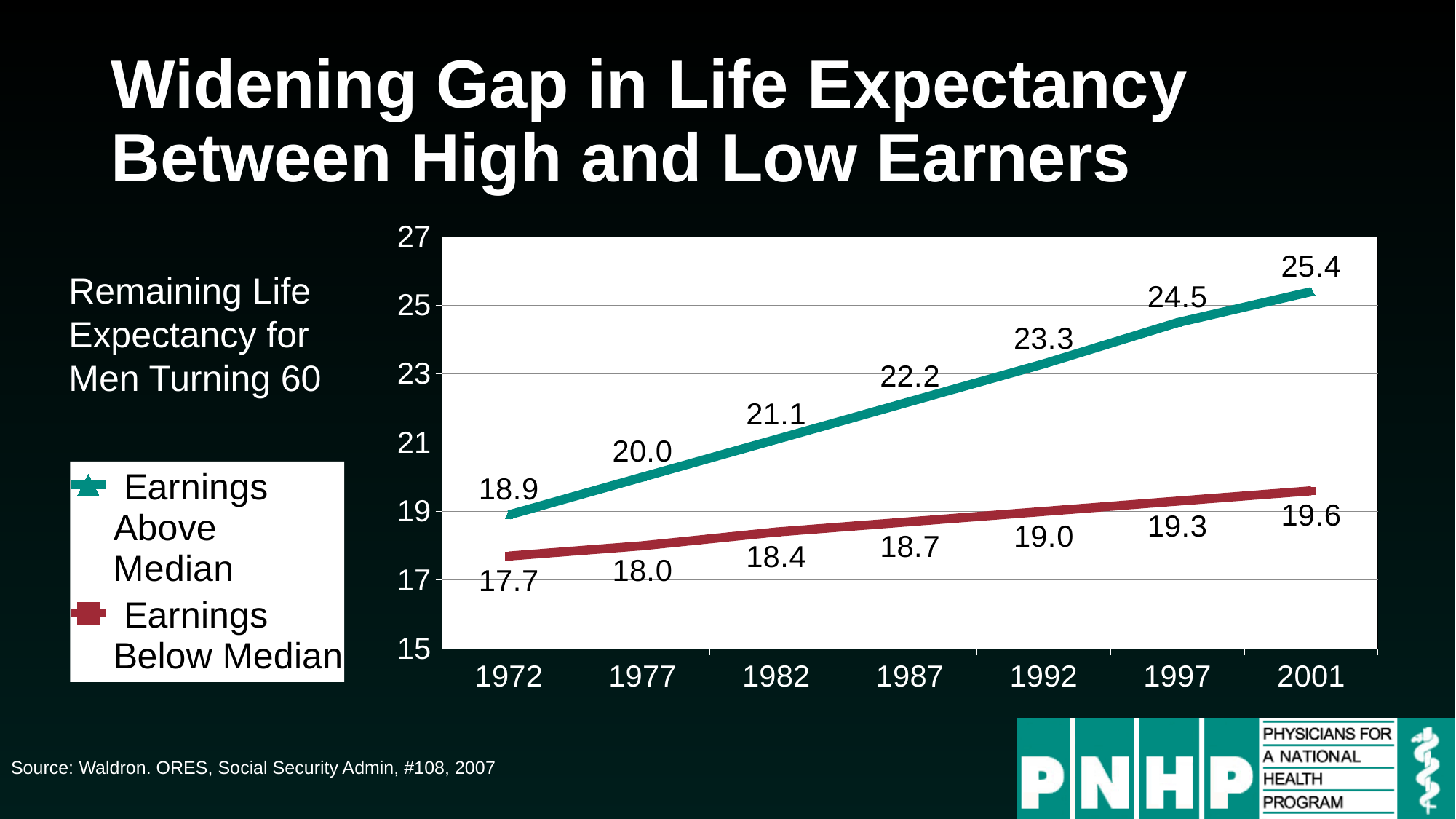
What is the value for Earnings Below Median in 1992? 19.0 In which year is the Earnings Below Median series lowest? 1972 In which year is the Earnings Above Median series highest? 2001 How many years are shown on the x axis? 7 What is the remaining life expectancy for Earnings Above Median in 2001? 25.4 What is the difference between Earnings Above Median and Earnings Below Median in 1972? 1.2 What is the remaining life expectancy for Earnings Below Median in 1972? 17.7 What is the difference between Earnings Above Median and Earnings Below Median in 2001? 5.8 Which series has the larger value in 1997, Earnings Above Median or Earnings Below Median? Earnings Above Median What kind of chart is shown on the slide? Line chart What is the value for Earnings Above Median in 1987? 22.2 How many series does the legend list? 2